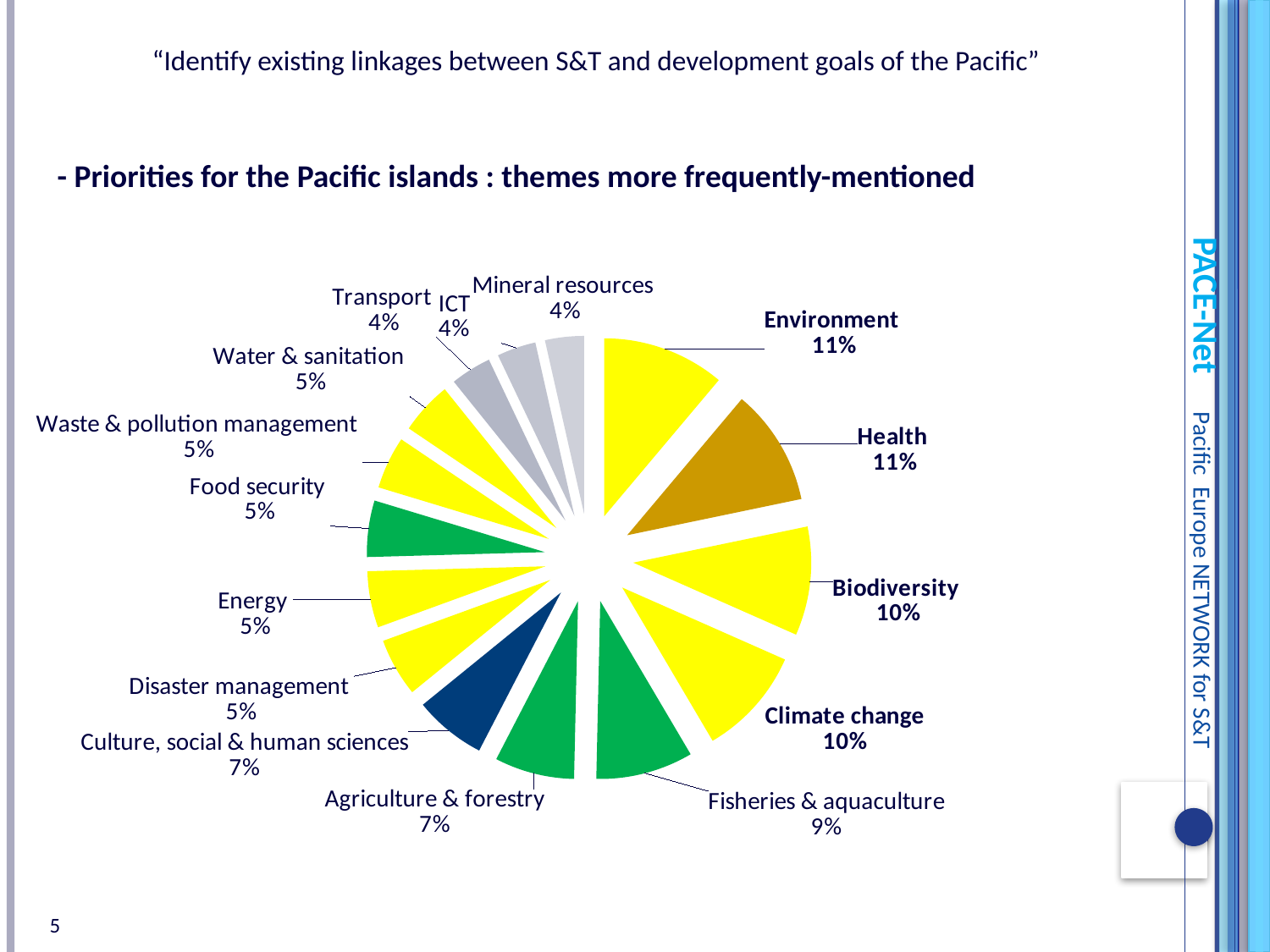
What is the value for Mineral resources? 4% What is the heading printed above the pie chart? - Priorities for the Pacific islands : themes more frequently-mentioned What kind of chart is shown on the slide? pie chart What share of the pie does Climate change account for? 10% What percentage is shown for Culture, social & human sciences? 7% What percentage does the Environment slice represent? 11% How many slices does the pie chart have? 15 Which is larger, Agriculture & forestry or Energy? Agriculture & forestry What is the value shown for Fisheries & aquaculture? 9% What is the difference in percentage points between Health and Agriculture & forestry? 4 percentage points What is the difference in percentage points between Environment and Transport? 7 percentage points Which is larger, Biodiversity or Fisheries & aquaculture? Biodiversity